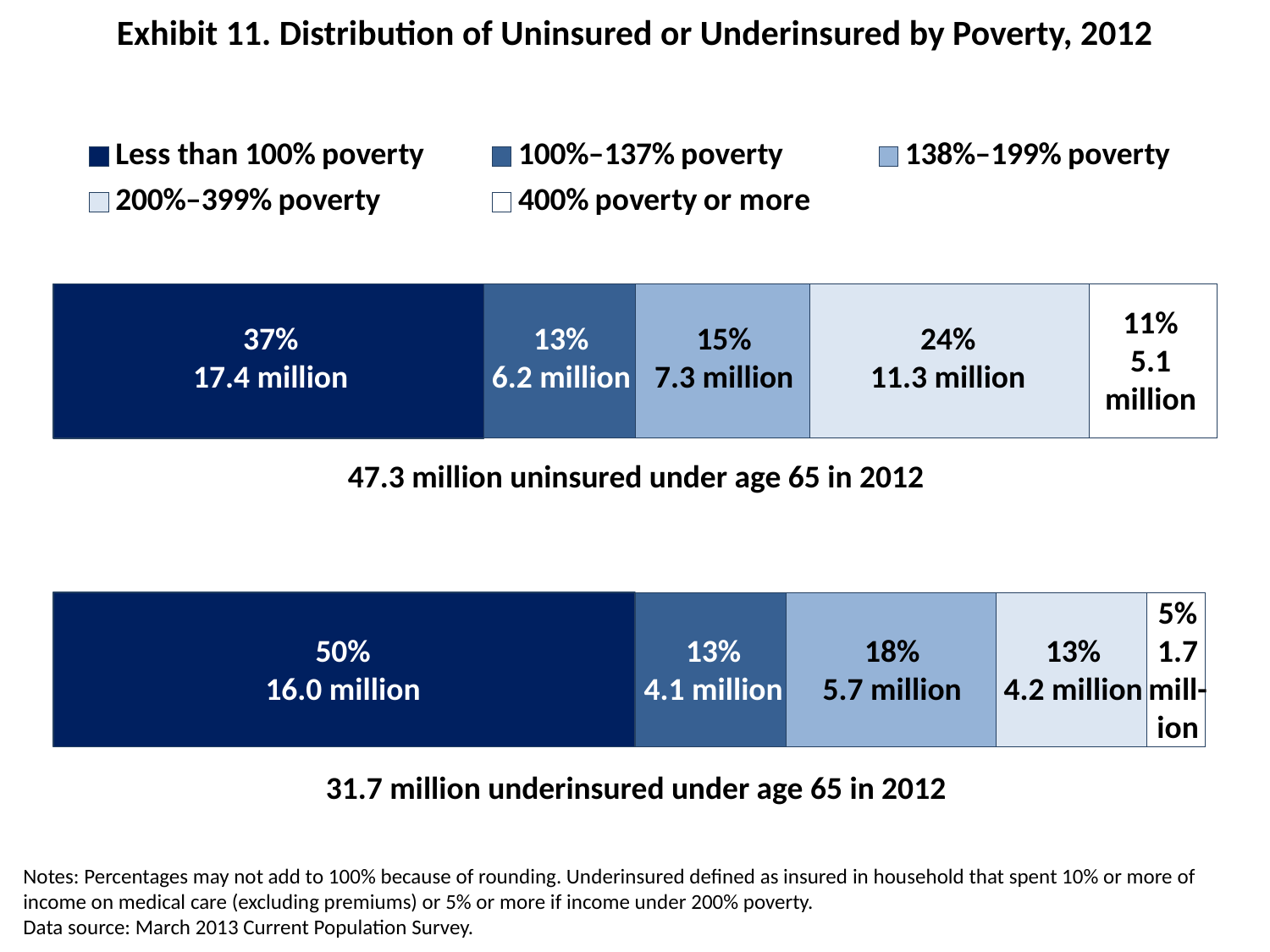
In the underinsured bar, how many million underinsured are in the 138%–199% poverty group? 5.7 million What kind of chart is used to show the distribution of uninsured and underinsured by poverty? Stacked bar chart In the uninsured bar, which poverty group has the smallest share? 400% poverty or more In the underinsured bar, which is larger: the 138%–199% poverty group or the 200%–399% poverty group? 138%–199% poverty In the uninsured bar, how many million uninsured are in the 200%–399% poverty group? 11.3 million What is the total number of uninsured under age 65 in 2012 shown below the top bar? 47.3 million In the uninsured bar, what is the difference in millions between the less than 100% poverty group and the 100%–137% poverty group? 11.2 million What is the total number of underinsured under age 65 in 2012 shown below the bottom bar? 31.7 million In the underinsured bar, which poverty group has the largest share? Less than 100% poverty In the uninsured bar, what percentage of the uninsured under age 65 are at less than 100% poverty? 37% How many poverty groups does the legend list? 5 In the underinsured bar, what percentage of the underinsured are at less than 100% poverty? 50%